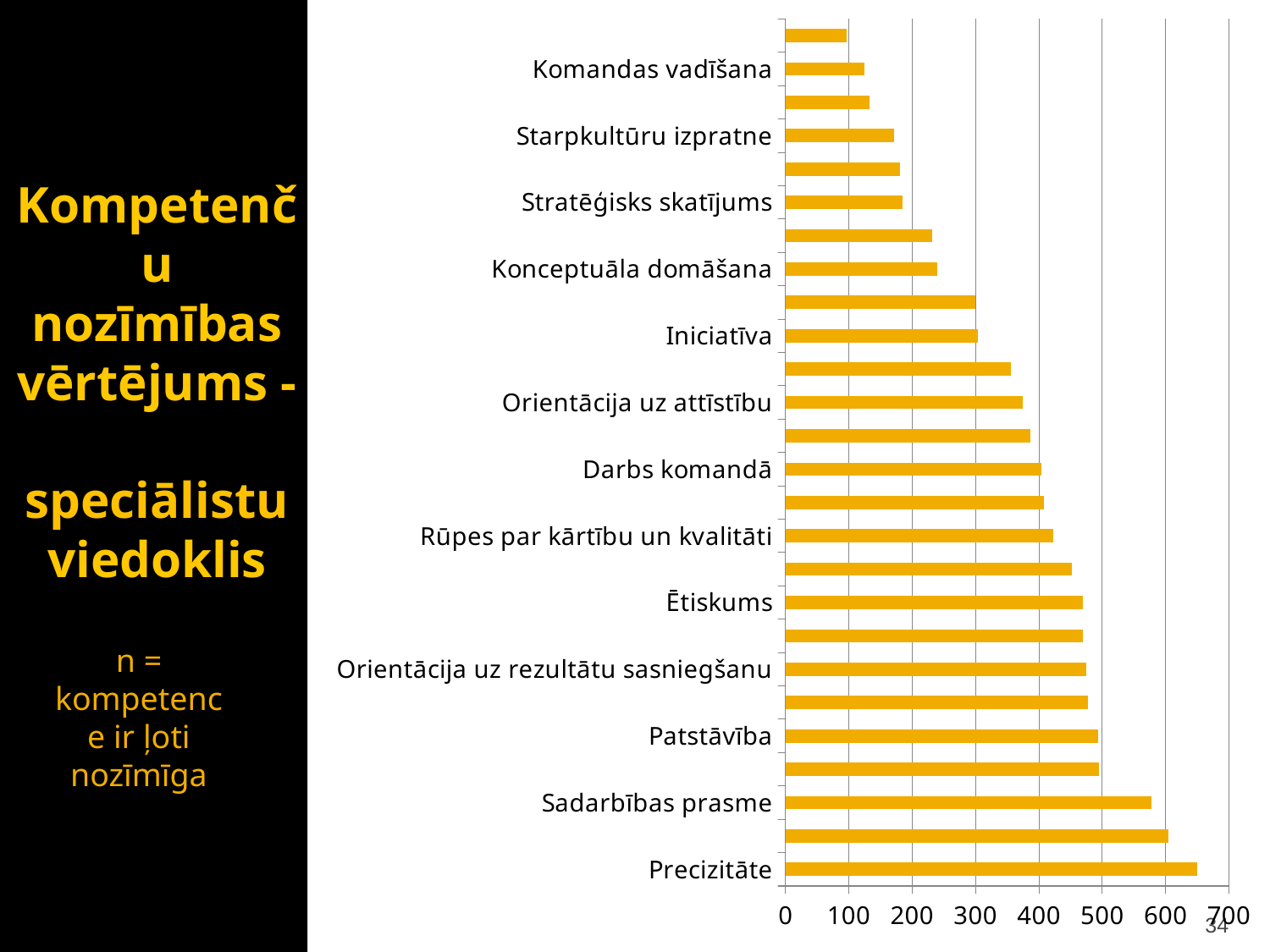
Which is larger, the value for Precizitāte or the value for Sadarbības prasme? Precizitāte Which category has the longest bar in the chart? Precizitāte Is the value for Ētiskums greater or less than 400? greater Is the value for Iniciatīva greater or less than 400? less Of the labeled categories, which has the shortest bar? Komandas vadīšana Do the bar lengths increase or decrease going from the top of the chart to the bottom? increase Which is larger, the value for Darbs komandā or the value for Iniciatīva? Darbs komandā Is the value for Komandas vadīšana greater or less than 100? greater What kind of chart is shown on the slide? bar chart